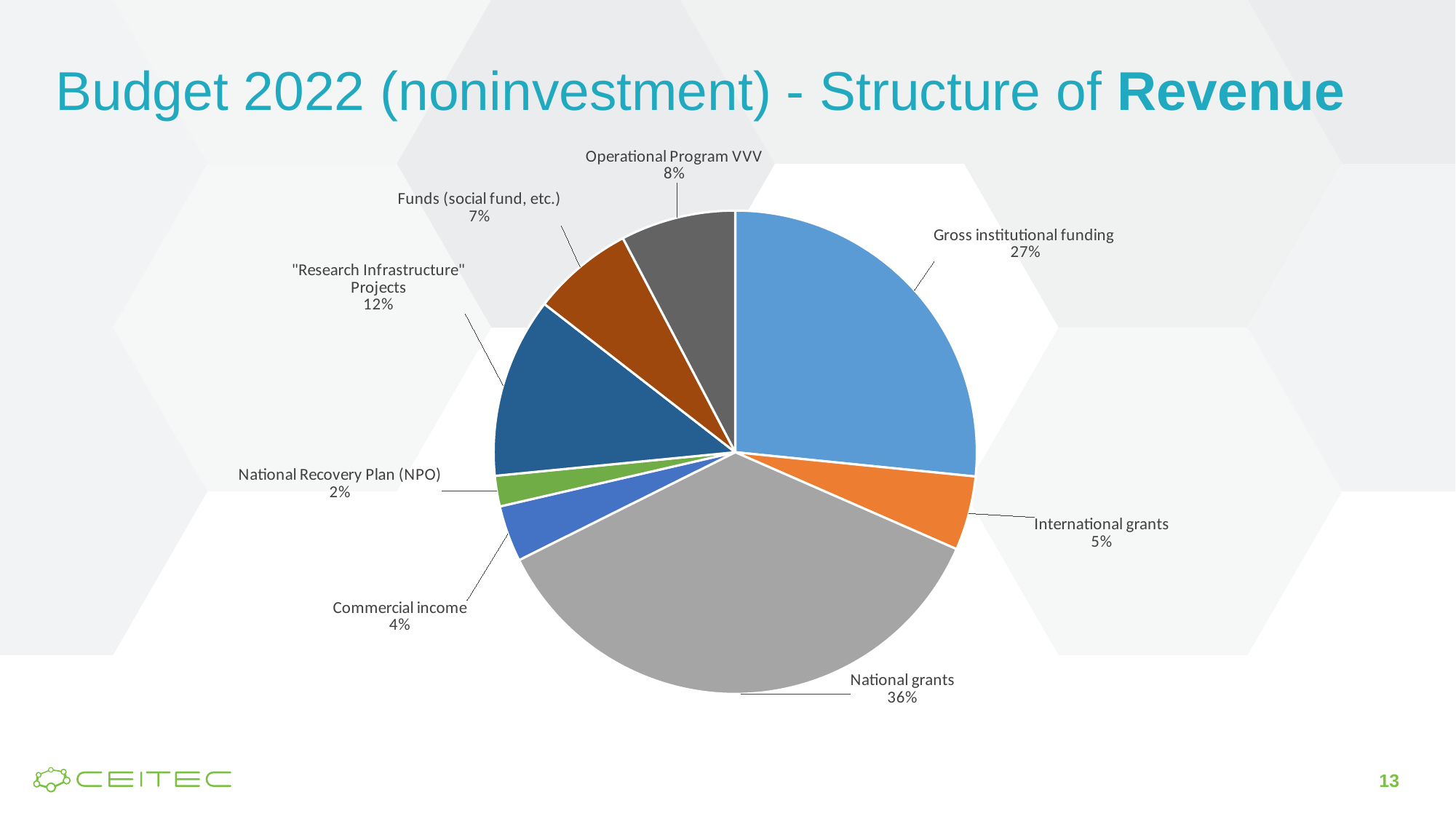
How many revenue categories are shown in the pie chart? 8 What is the title of the slide? Budget 2022 (noninvestment) - Structure of Revenue What percentage is shown for "Research Infrastructure" Projects? 12% What percentage is shown for Operational Program VVV? 8% Which is larger, the share for International grants or the share for Funds (social fund, etc.)? Funds (social fund, etc.) What share of revenue comes from Gross institutional funding? 27% What share of revenue comes from Commercial income? 4% Which revenue source has the smallest share? National Recovery Plan (NPO) What is the difference in percentage points between National grants and Gross institutional funding? 9 Which revenue source has the largest share? National grants What type of chart is shown on the slide? Pie chart What share of revenue comes from National grants? 36%